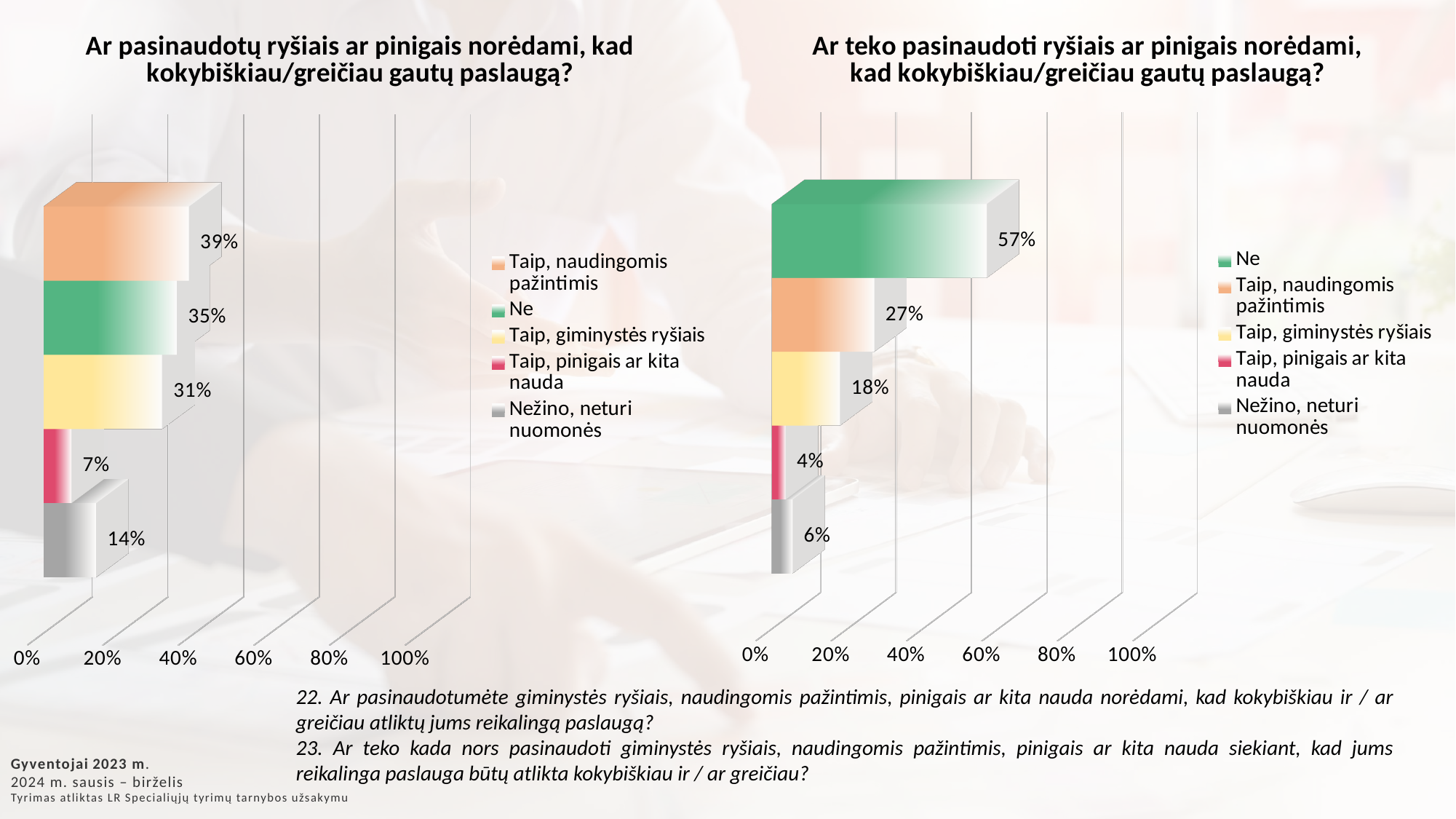
In the right chart, is the value for "Ne" greater or less than 40%? greater In the right chart, what is the difference between "Ne" and "Taip, naudingomis pažintimis"? 30% In the right chart, what is the value for "Nežino, neturi nuomonės"? 6% In the left chart, what is the value for "Taip, pinigais ar kita nauda"? 7% What kind of chart is the right chart? bar chart How many categories are plotted in the left chart? 5 In the left chart, which category has the highest value? Taip, naudingomis pažintimis In the left chart ("Ar pasinaudotų ryšiais ar pinigais norėdami, kad kokybiškiau/greičiau gautų paslaugą?"), what is the value for "Taip, naudingomis pažintimis"? 39% In the left chart, which is larger: "Ne" or "Taip, giminystės ryšiais"? Ne In the left chart, what colour is the bar for "Taip, giminystės ryšiais"? yellow In the right chart ("Ar teko pasinaudoti ryšiais ar pinigais norėdami, kad kokybiškiau/greičiau gautų paslaugą?"), what is the value for "Ne"? 57% In the right chart, which category has the lowest value? Taip, pinigais ar kita nauda